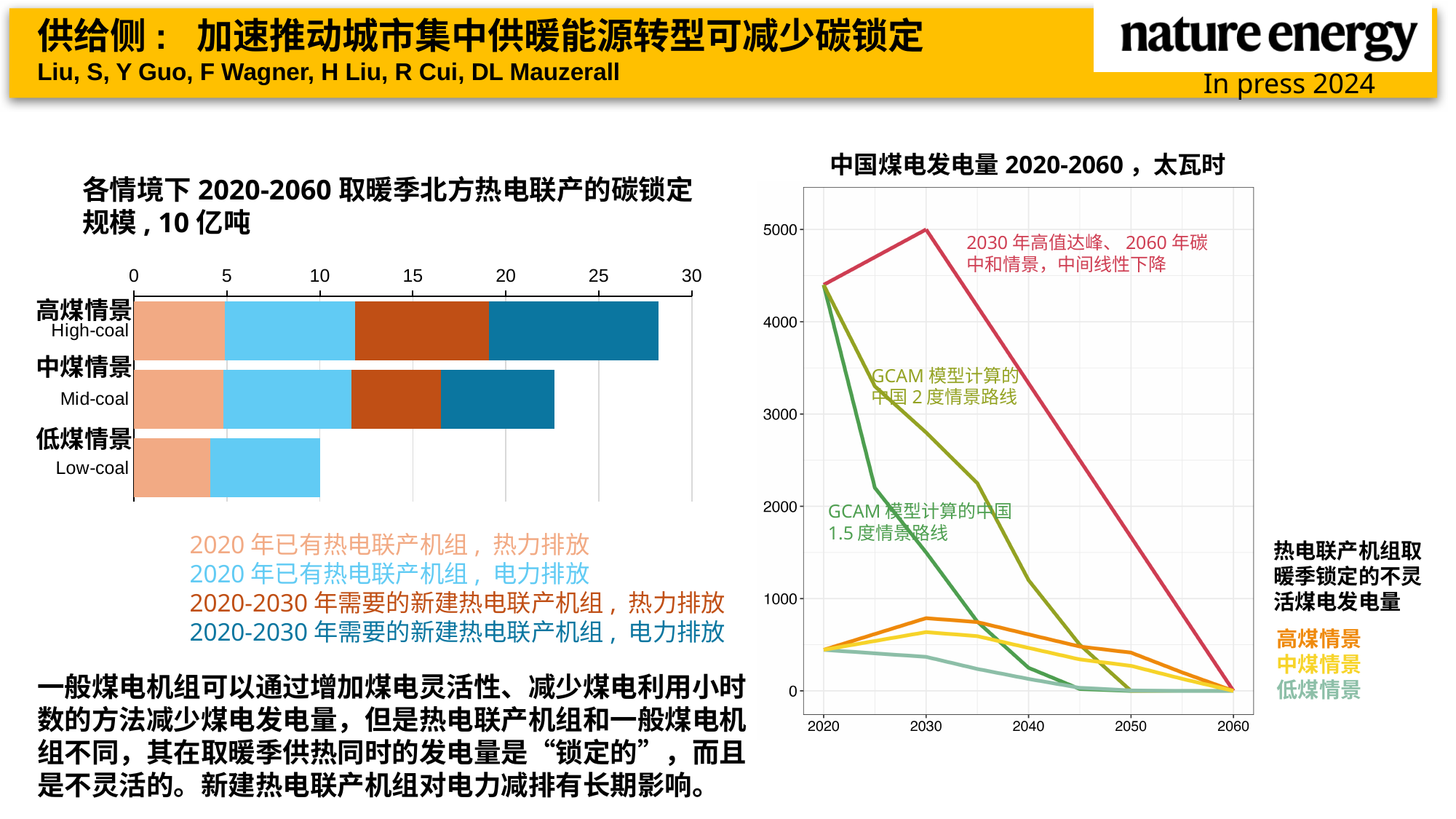
In the right line chart, does the red line rise or fall between 2030 and 2060? Fall What kind of chart is the left chart, 各情境下 2020-2060 取暖季北方热电联产的碳锁定规模? Bar chart In the left bar chart, is the total for 高煤情景 (High-coal) greater or less than 25? greater In the left bar chart, which scenario has the smallest total carbon lock-in? 低煤情景 (Low-coal) In the right line chart, in which year does the red line (2030 年高值达峰、2060 年碳中和情景) reach its peak? 2030 In the left bar chart, which scenario has the largest total carbon lock-in? 高煤情景 (High-coal) In the left bar chart, is the total for 低煤情景 (Low-coal) greater or less than 15? less In the left bar chart, how many scenarios (categories) are plotted? 3 In the left bar chart, how many series does the legend list? 4 In the right line chart, is the 2020 value of the red line greater or less than 4000? greater In the left bar chart, which has the larger total, 中煤情景 (Mid-coal) or 低煤情景 (Low-coal)? 中煤情景 (Mid-coal) What kind of chart is the right chart, 中国煤电发电量 2020-2060? Line chart